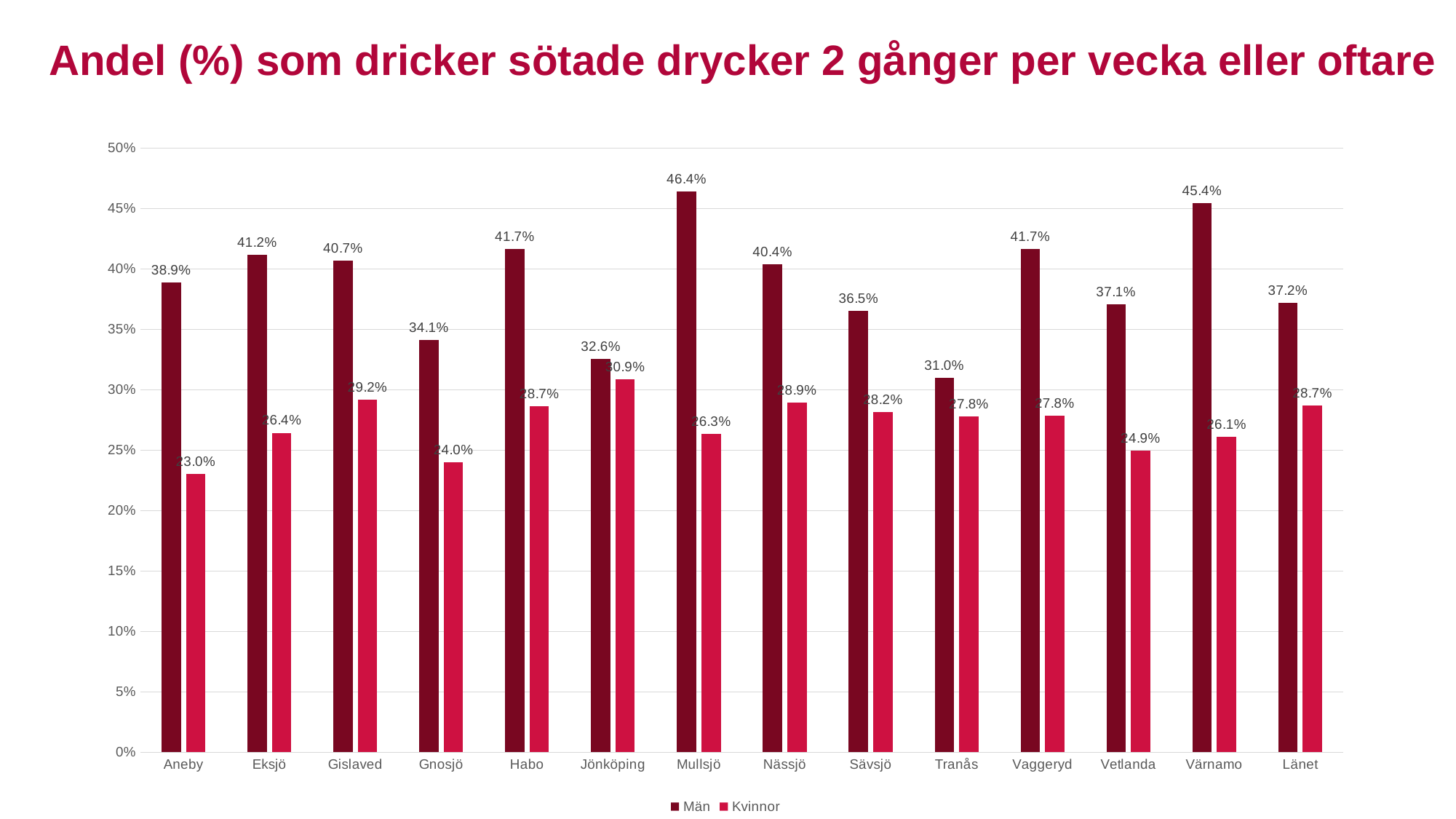
Which municipality has the highest value for Män? Mullsjö What is the value for Kvinnor in Jönköping? 30.9% Is the value for Kvinnor in Gnosjö greater or less than 25%? less What kind of chart is shown on the slide? Bar chart How many categories are shown on the x axis? 14 How many series does the legend list? 2 Which category has the lowest value for Kvinnor? Aneby What is the difference between the Män and Kvinnor values in Mullsjö? 20.1 percentage points What is the value for Kvinnor in Länet? 28.7% Which is larger: the Män value in Värnamo or the Män value in Vetlanda? Värnamo Which municipality has the lowest value for Män? Tranås What is the value for Män in Mullsjö? 46.4%